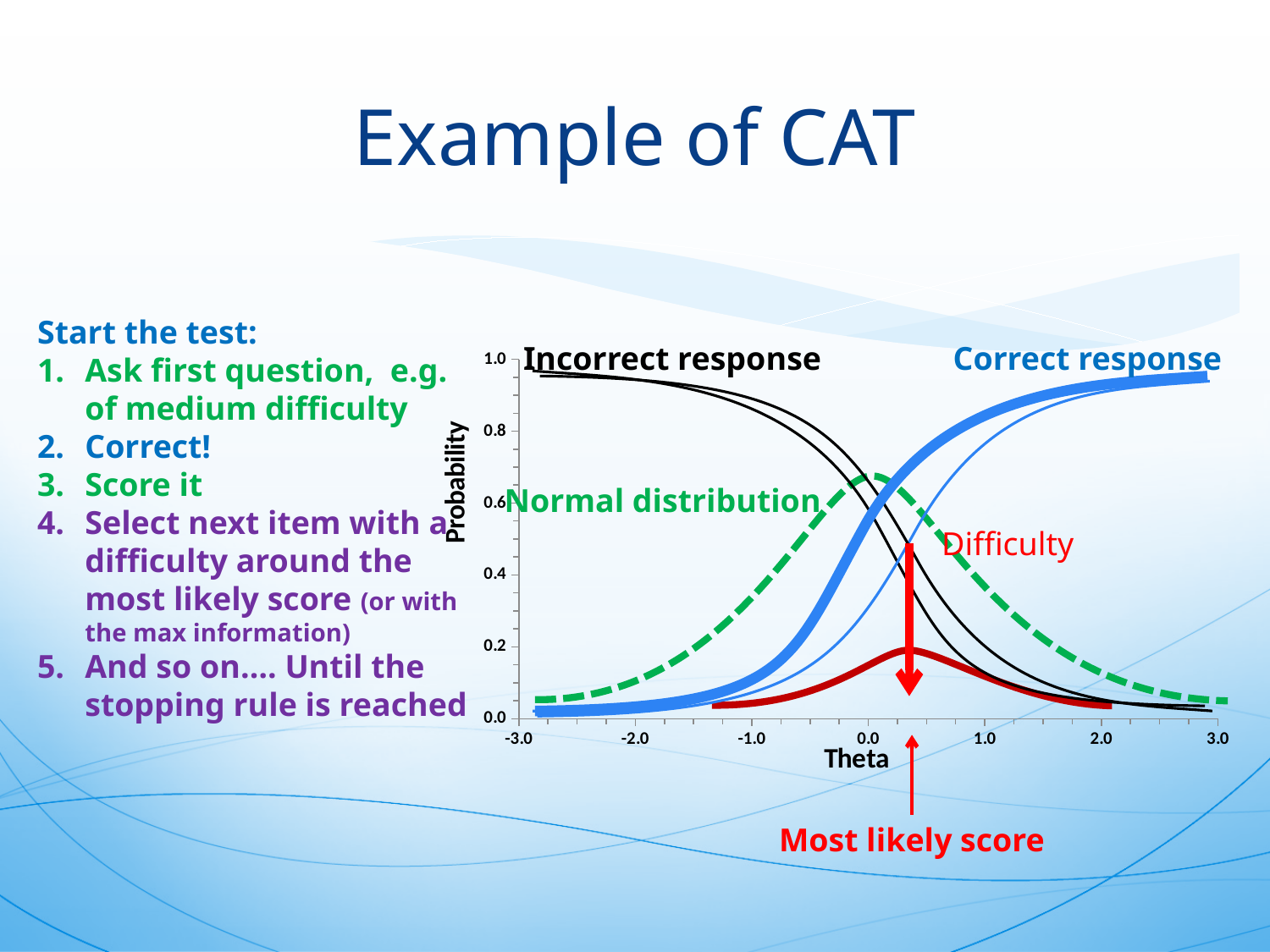
Does the 'Correct response' curve rise or fall as Theta increases? rises What is the label of the vertical axis of the chart? Probability Is the peak of the red 'Difficulty' curve greater or less than 0.4? less At Theta 2.0, which curve has the higher probability: 'Correct response' or 'Incorrect response'? Correct response Is the value of the 'Incorrect response' curve at Theta -3.0 greater or less than 0.8? greater What is the label of the horizontal axis of the chart? Theta Does the 'Incorrect response' curve rise or fall as Theta increases? falls What kind of chart is shown on the slide? line chart Is the peak of the 'Normal distribution' curve greater or less than 0.8? less At Theta -2.0, which curve has the higher probability: 'Correct response' or 'Incorrect response'? Incorrect response How many labelled tick marks are shown on the Theta axis? 7